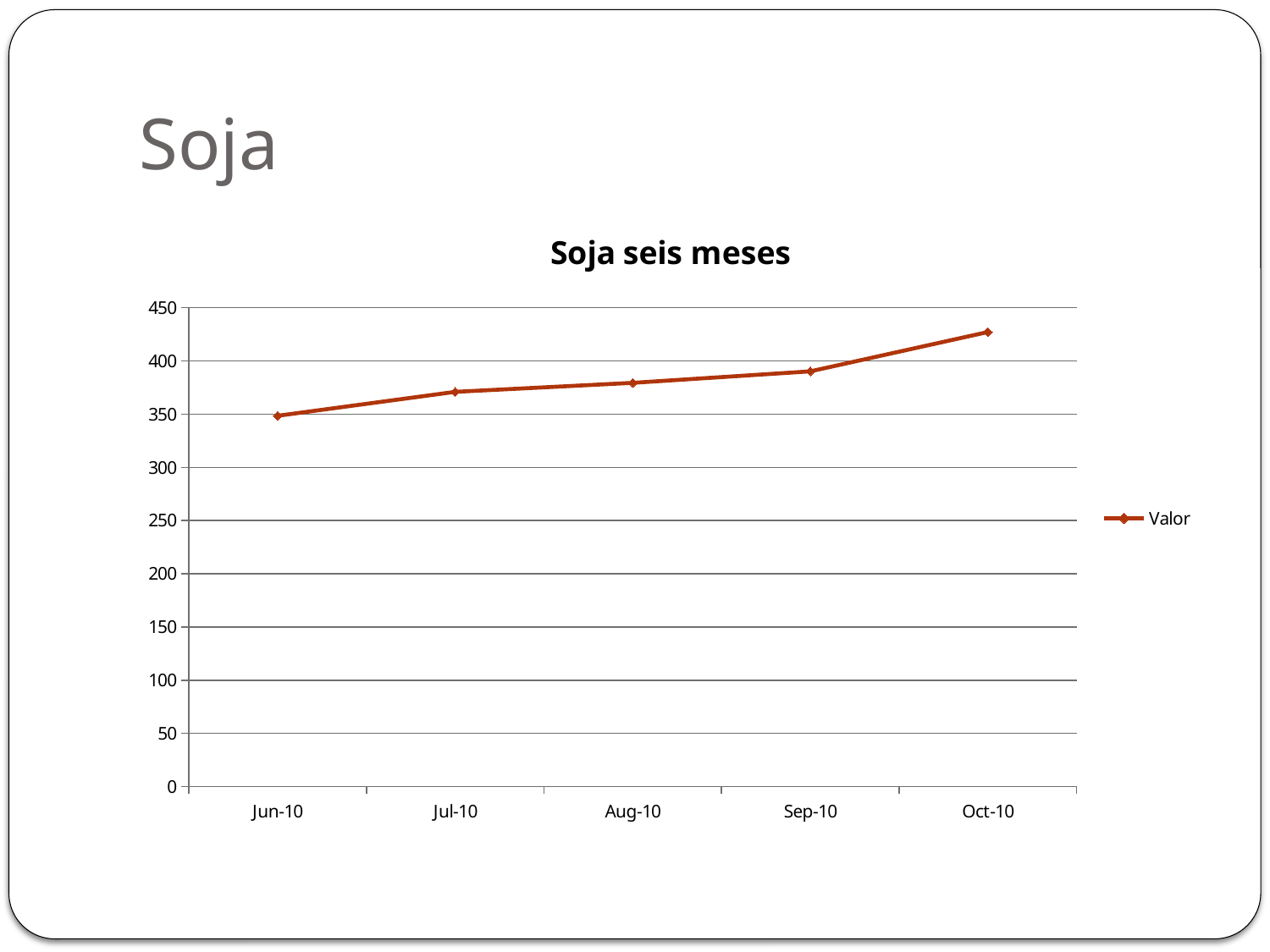
What is the name of the series shown in the legend? Valor Which month has the lowest value? Jun-10 What type of chart is shown on the slide? Line chart Is the value for Jul-10 greater or less than 350? greater How many data points are plotted on the chart? 5 Which is larger, the value for Oct-10 or the value for Jun-10? Oct-10 Do the values rise or fall from Jun-10 to Oct-10? Rise What is the title of the chart? Soja seis meses Which month has the highest value? Oct-10 Is the value for Oct-10 greater or less than 400? greater How many series does the legend list? 1 Which is larger, the value for Sep-10 or the value for Jul-10? Sep-10